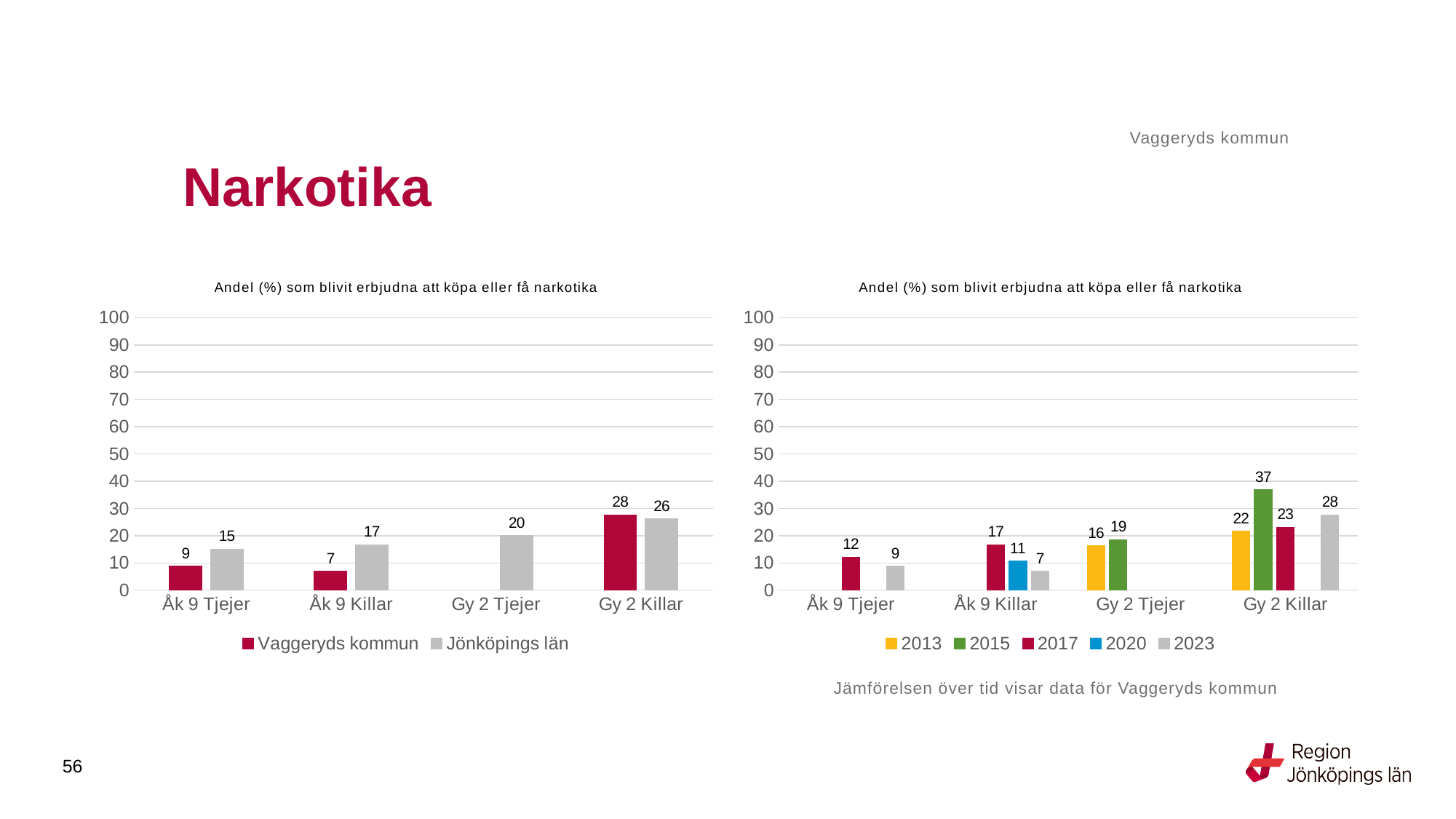
In the left chart, what is the value for Jönköpings län for Gy 2 Tjejer? 20 In the left chart, how many series does the legend list? 2 In the left chart, which category has the highest value for Jönköpings län? Gy 2 Killar In the left chart, what is the value for Vaggeryds kommun for Gy 2 Killar? 28 In the left chart, what is the difference between Jönköpings län and Vaggeryds kommun for Åk 9 Killar? 10 In the right chart, which year has the lowest value for Åk 9 Killar? 2023 In the right chart, how many series does the legend list? 5 In the left chart, which is larger for Åk 9 Tjejer: Vaggeryds kommun or Jönköpings län? Jönköpings län In the right chart, what is the difference between the 2015 and 2013 values for Gy 2 Killar? 15 What type of chart is the right chart? Bar chart In the right chart, what is the value for 2015 for Gy 2 Killar? 37 In the right chart, what is the value for 2020 for Åk 9 Killar? 11